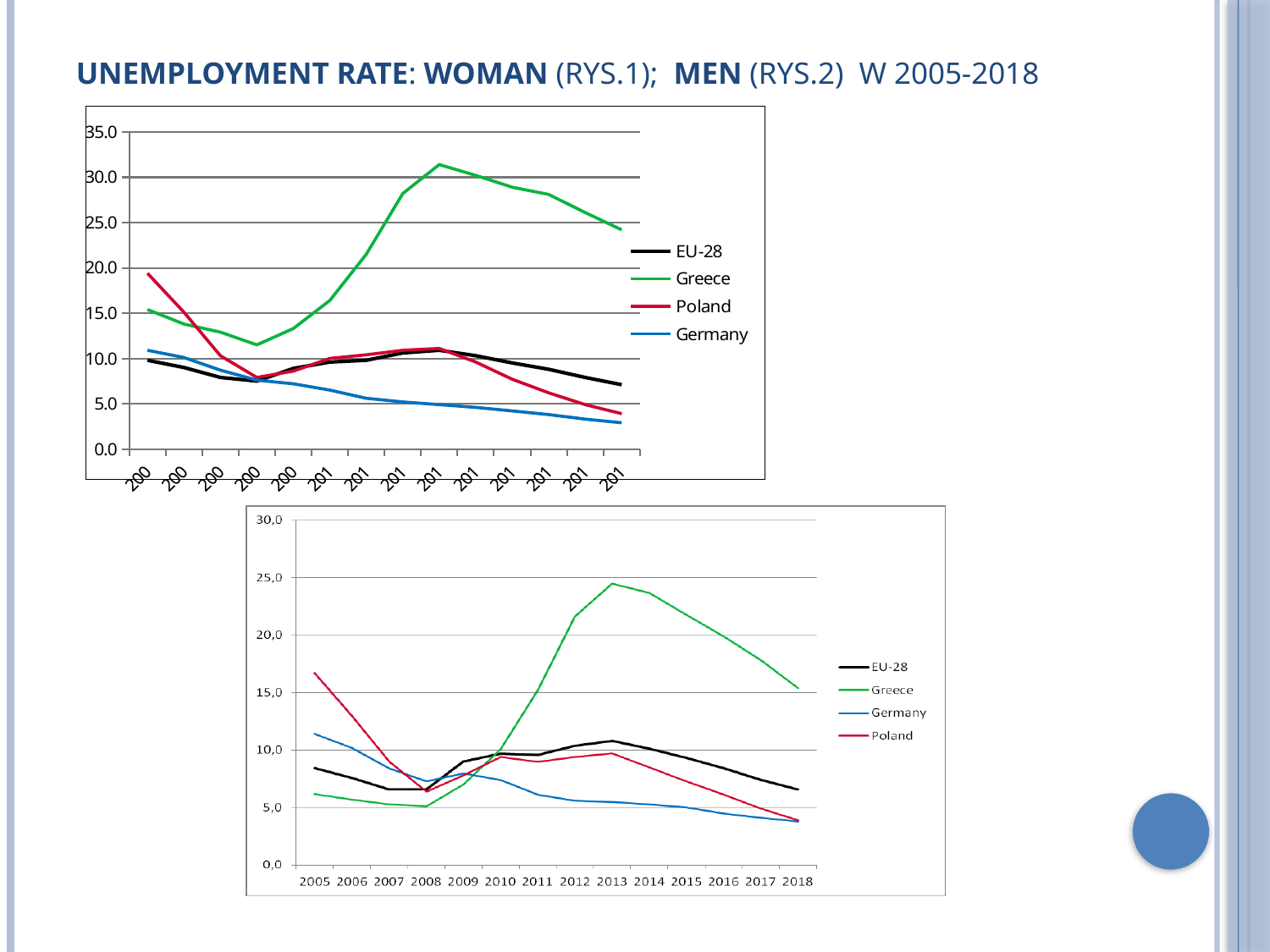
In the bottom chart (RYS.2, men), is the value for Greece in 2008 greater or less than 10,0? less What type of chart is the top chart (RYS.1, women)? line chart In the bottom chart (RYS.2, men), which series has the lowest value in 2005? Greece In the top chart (RYS.1, women), which series is shown in black in the legend? EU-28 In the bottom chart (RYS.2, men), which is larger in 2005: Poland or Germany? Poland In the bottom chart (RYS.2, men), is the value for Poland in 2005 greater or less than 15,0? greater In the top chart (RYS.1, women), which series reaches the highest value on the chart? Greece In the bottom chart (RYS.2, men), does the Greece line rise or fall from 2013 to 2018? fall In the bottom chart (RYS.2, men), is the value for Greece in 2013 greater or less than 20,0? greater How many series does the legend of the bottom chart (RYS.2, men) list? 4 In the bottom chart (RYS.2, men), which series has the highest value in 2013? Greece In the bottom chart (RYS.2, men), how many years are shown on the x axis? 14